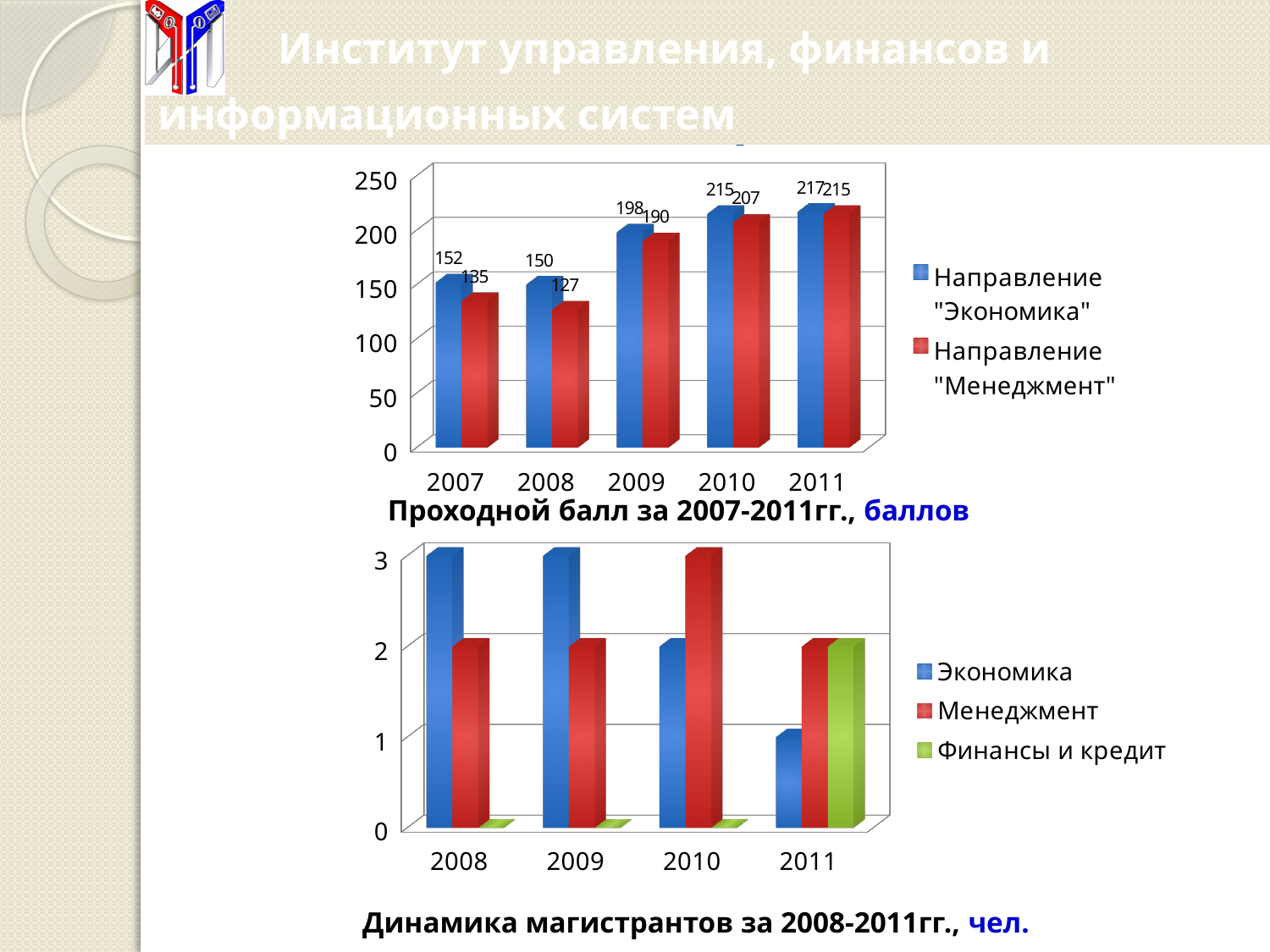
In the chart 'Проходной балл за 2007-2011гг., баллов', which year has the highest value for Направление "Менеджмент"? 2011 In the chart 'Проходной балл за 2007-2011гг., баллов', which is larger in 2010: Направление "Экономика" or Направление "Менеджмент"? Направление "Экономика" In the chart 'Проходной балл за 2007-2011гг., баллов', do the values for Направление "Менеджмент" generally rise or fall from 2008 to 2011? rise How many years are shown on the x axis of the chart 'Проходной балл за 2007-2011гг., баллов'? 5 What kind of chart is 'Динамика магистрантов за 2008-2011гг., чел.'? bar chart In the chart 'Проходной балл за 2007-2011гг., баллов', what is the value for Направление "Экономика" in 2009? 198 In the chart 'Проходной балл за 2007-2011гг., баллов', what is the difference between Направление "Экономика" and Направление "Менеджмент" in 2007? 17 In the chart 'Динамика магистрантов за 2008-2011гг., чел.', what is the value for Менеджмент in 2010? 3 In the chart 'Проходной балл за 2007-2011гг., баллов', what is the value for Направление "Менеджмент" in 2008? 127 In the chart 'Динамика магистрантов за 2008-2011гг., чел.', which series is shown in green in the legend? Финансы и кредит How many series does the legend of the chart 'Динамика магистрантов за 2008-2011гг., чел.' list? 3 In the chart 'Проходной балл за 2007-2011гг., баллов', which year has the lowest value for Направление "Экономика"? 2008